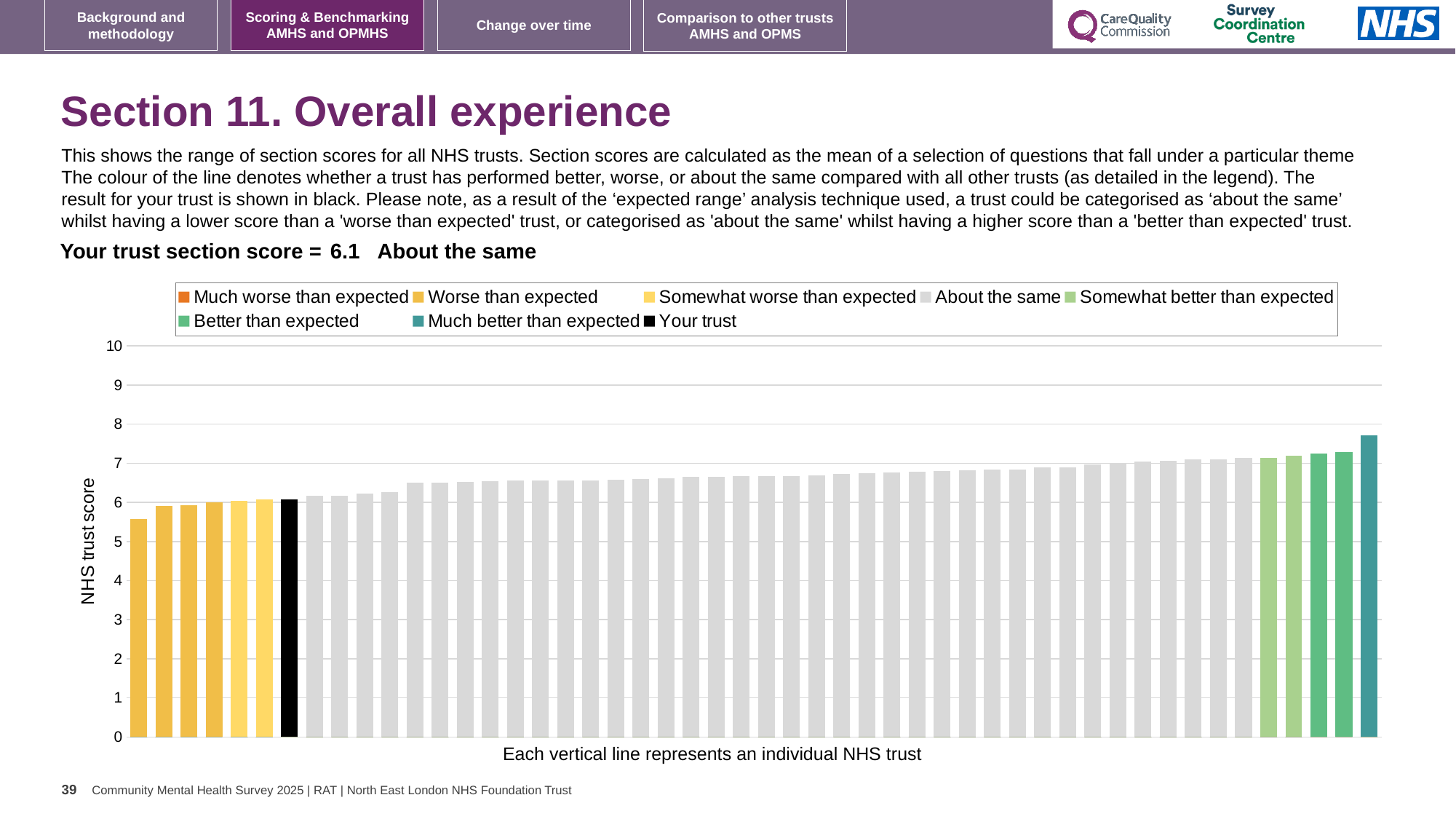
Is the value of the highest bar greater or less than 7? greater What is the section score for your trust? 6.1 Which legend category does the highest bar belong to? Much better than expected Is the value of the lowest bar greater or less than 6? less How many entries does the chart legend list? 8 Which legend category does the lowest bar belong to? Worse than expected Is the value of the black 'Your trust' bar greater or less than 5? greater What kind of chart is shown on the slide? bar chart How many bars are coloured as 'Much better than expected'? 1 Do the bar values rise or fall from left to right along the x axis? rise What is the label on the y axis of the chart? NHS trust score